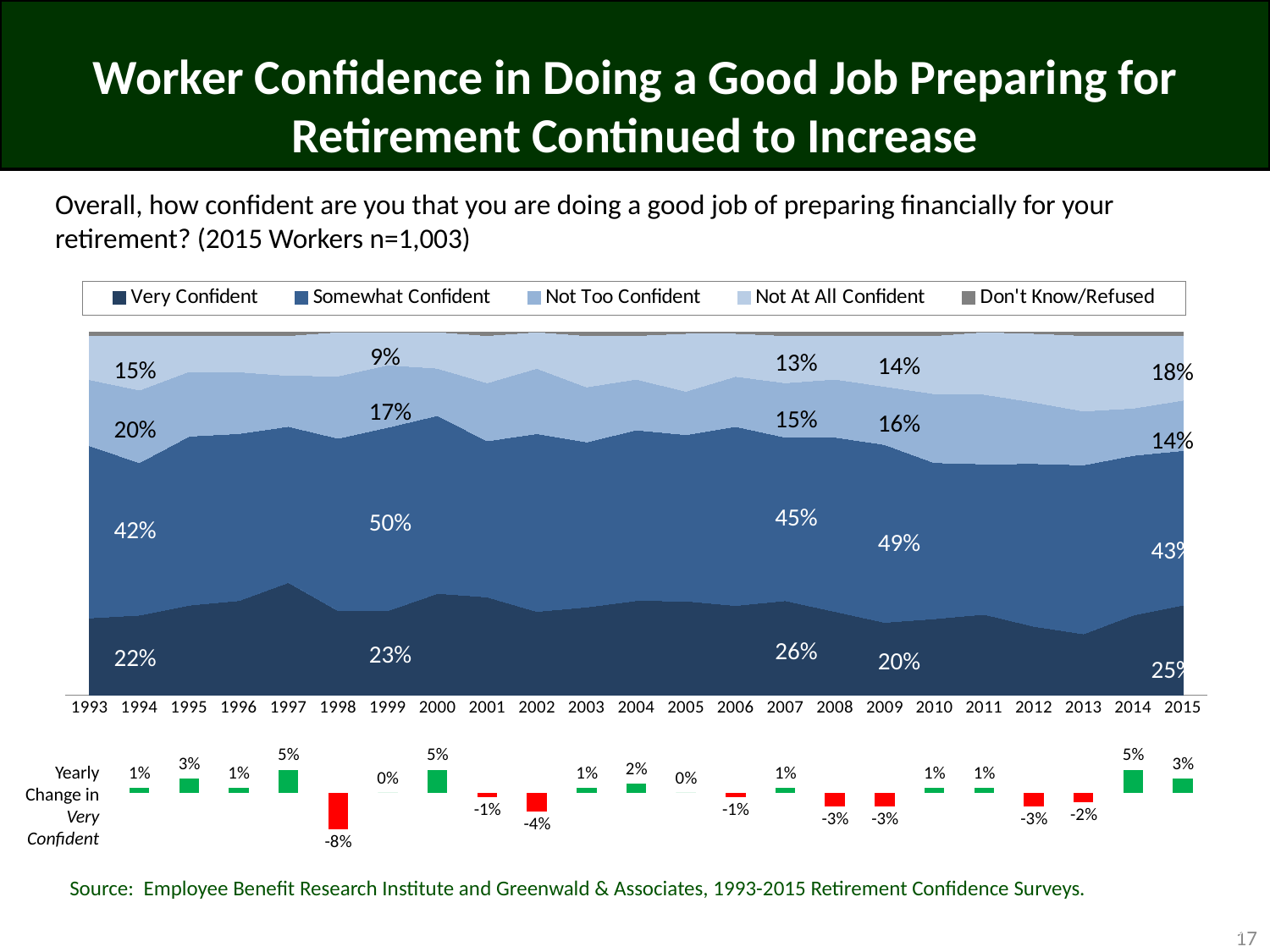
What kind of chart is the main chart showing confidence levels from 1993 to 2015? Stacked area chart How many series does the legend of the stacked area chart list? 5 How many years are shown on the x axis of the stacked area chart? 23 In the bottom chart of yearly change in Very Confident, which year has the lowest value? 1998 In the stacked area chart, what percentage of workers were Not Too Confident in 2009? 16% In the stacked area chart, was the Somewhat Confident share larger in 2007 or in 2015? 2007 What kind of chart is the small chart at the bottom showing the yearly change in Very Confident? Bar chart In the stacked area chart, what percentage of workers were Not At All Confident in 2015? 18% In the stacked area chart, what percentage of workers were Somewhat Confident in 1999? 50% In the stacked area chart, what is the difference between the Very Confident share in 2015 and in 2009? 5 percentage points In the bottom chart of yearly change in Very Confident, what is the value for 1998? -8%